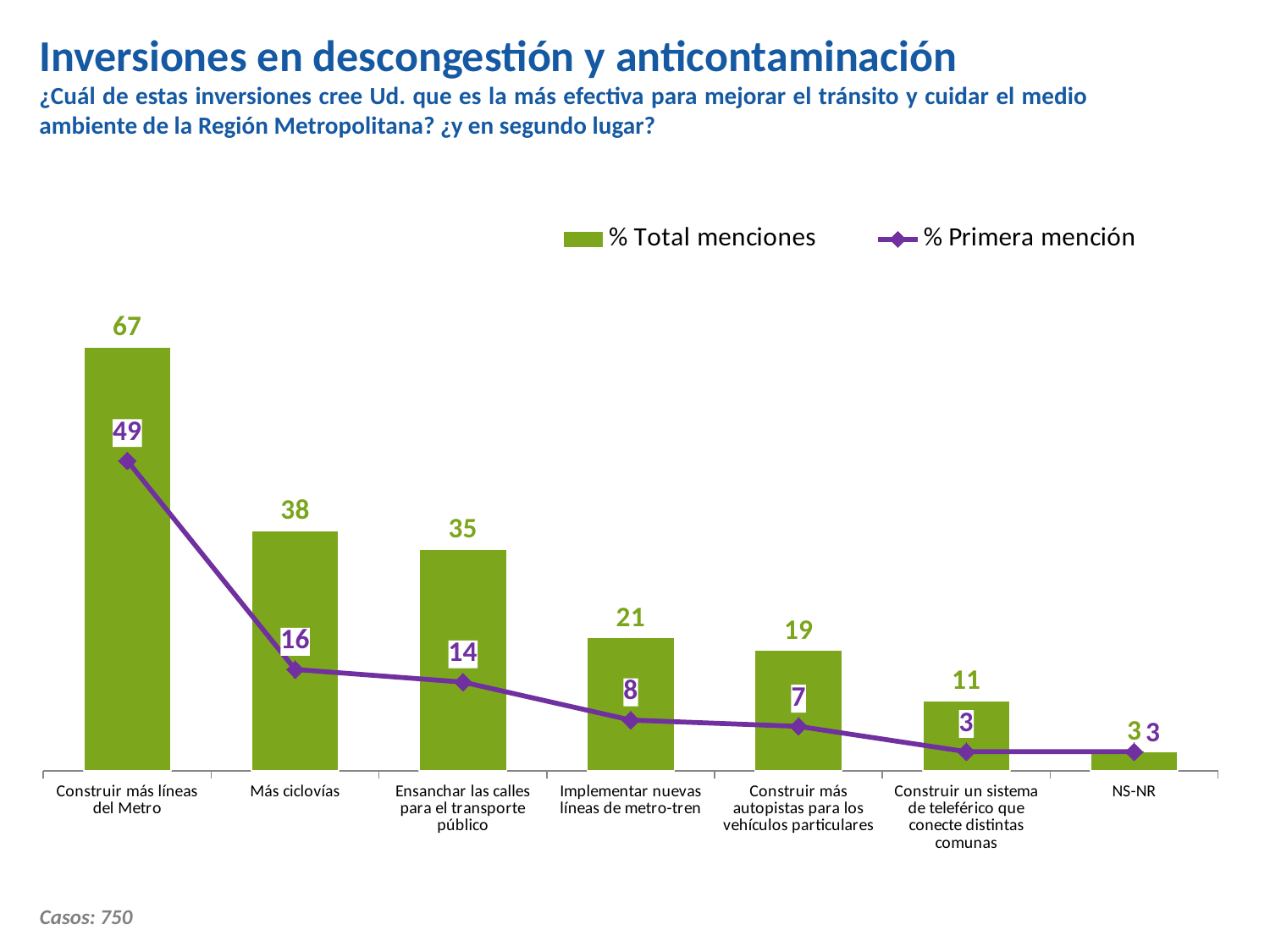
What is the % Primera mención value for Construir más líneas del Metro? 49 Which category has the lowest % Total menciones? NS-NR What is the difference between % Total menciones and % Primera mención for Ensanchar las calles para el transporte público? 21 How many series does the legend list? 2 Which is larger: the % Total menciones for Más ciclovías or for Ensanchar las calles para el transporte público? Más ciclovías What is the % Total menciones value for Implementar nuevas líneas de metro-tren? 21 Which category has the highest % Total menciones? Construir más líneas del Metro What is the % Primera mención value for Construir más autopistas para los vehículos particulares? 7 What is the % Total menciones value for Más ciclovías? 38 Do the % Primera mención values rise or fall from left to right along the x axis? Fall How many categories are shown on the x axis? 7 What kind of chart is this? Combined bar and line chart